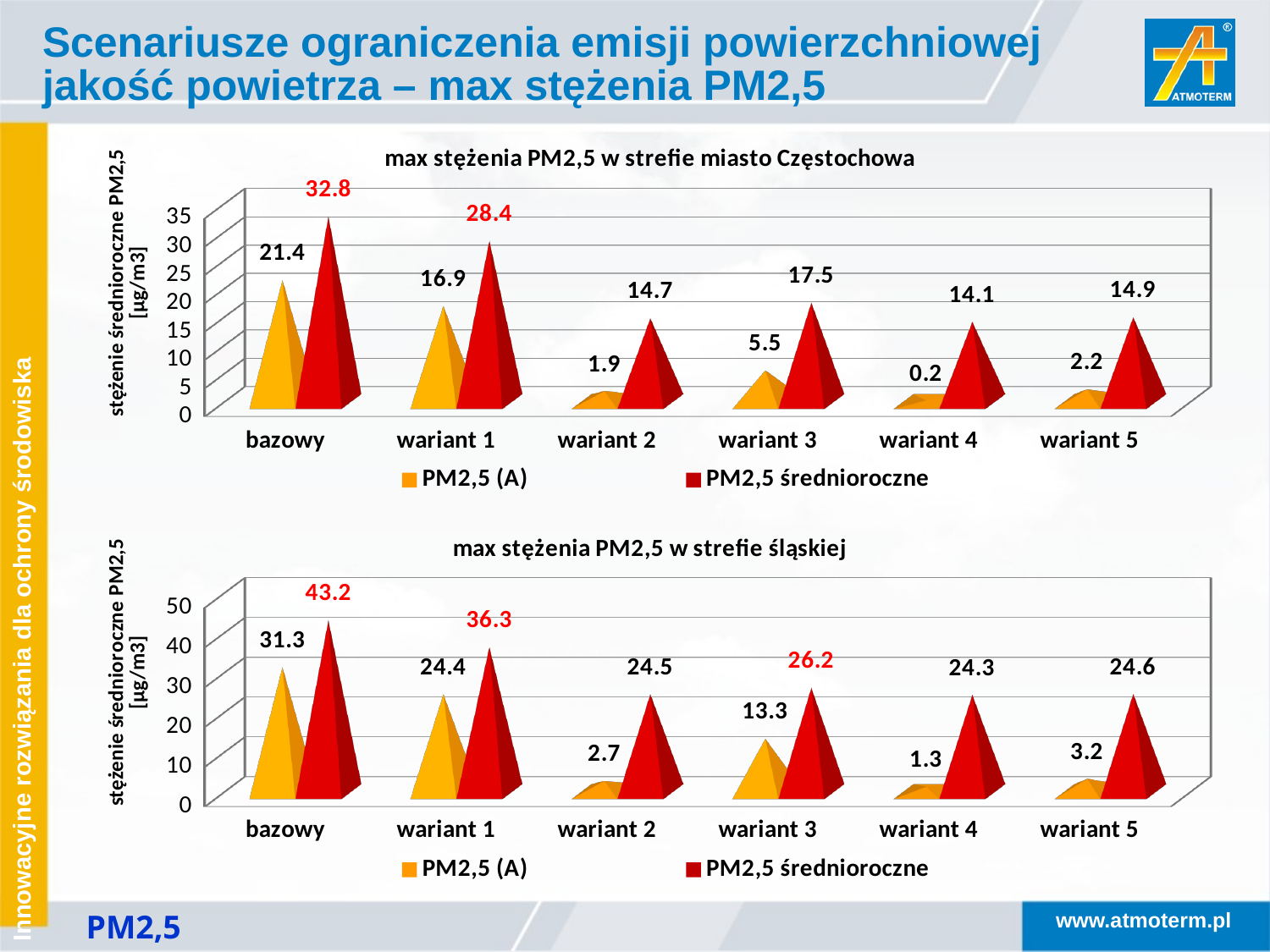
In the chart 'max stężenia PM2,5 w strefie śląskiej', what is the difference between the PM2,5 średnioroczne and PM2,5 (A) values for bazowy? 11.9 In the chart 'max stężenia PM2,5 w strefie miasto Częstochowa', what is the value of PM2,5 średnioroczne for bazowy? 32.8 In the chart 'max stężenia PM2,5 w strefie miasto Częstochowa', what is the difference between the PM2,5 średnioroczne values for bazowy and wariant 1? 4.4 In the chart 'max stężenia PM2,5 w strefie śląskiej', which category has the highest PM2,5 (A) value? bazowy How many series does the legend of the chart 'max stężenia PM2,5 w strefie śląskiej' list? 2 In the chart 'max stężenia PM2,5 w strefie śląskiej', which is larger: the PM2,5 (A) value for wariant 1 or for wariant 3? wariant 1 In the chart 'max stężenia PM2,5 w strefie śląskiej', what is the value of PM2,5 (A) for wariant 3? 13.3 In the chart 'max stężenia PM2,5 w strefie miasto Częstochowa', how many categories are shown on the x axis? 6 In the chart 'max stężenia PM2,5 w strefie miasto Częstochowa', which category has the lowest PM2,5 średnioroczne value? wariant 4 What type of chart is 'max stężenia PM2,5 w strefie miasto Częstochowa'? bar chart In the chart 'max stężenia PM2,5 w strefie śląskiej', what is the value of PM2,5 średnioroczne for wariant 5? 24.6 In the chart 'max stężenia PM2,5 w strefie miasto Częstochowa', what is the value of PM2,5 (A) for wariant 4? 0.2